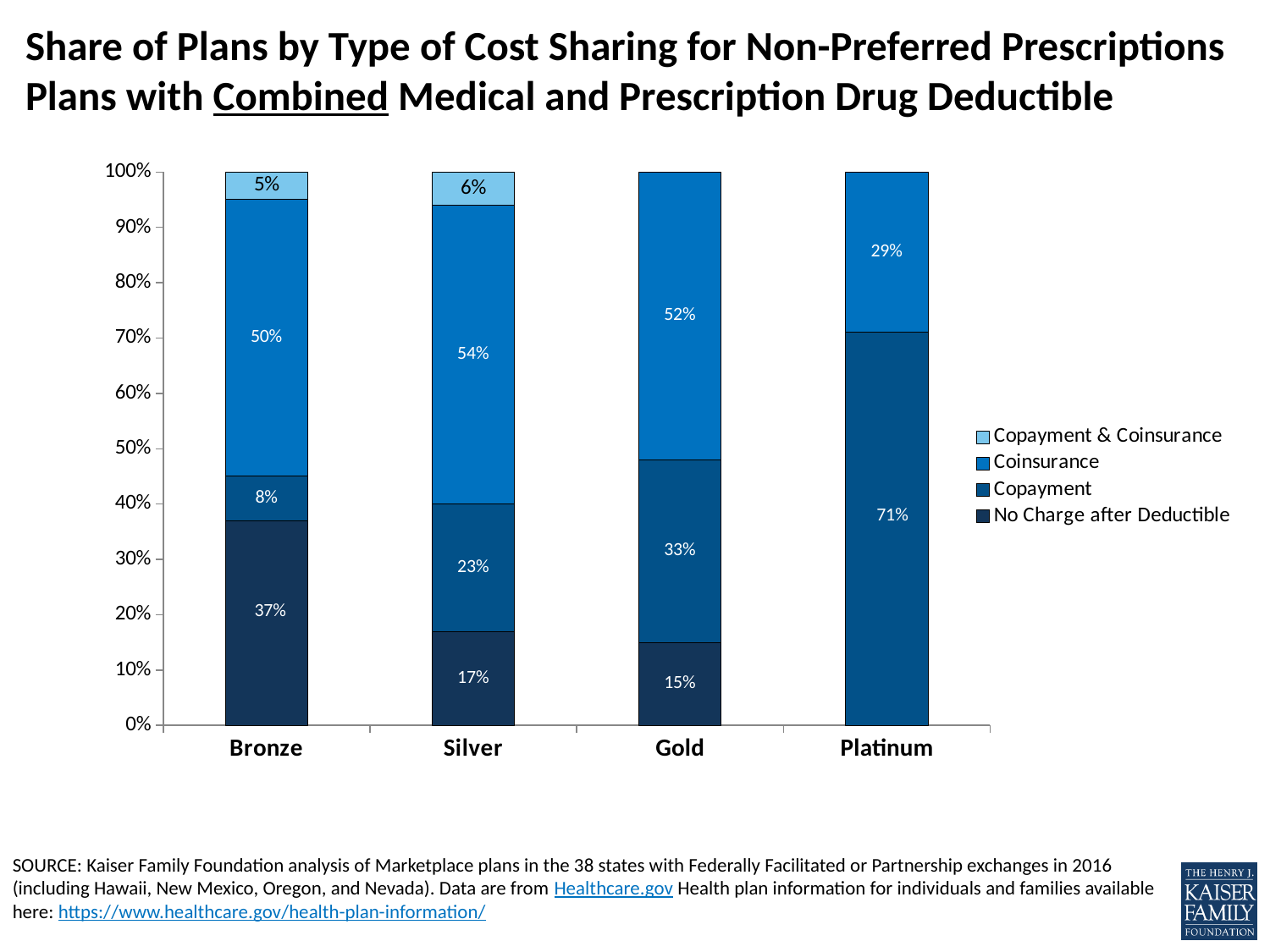
What is the difference in percentage points between the Copayment share for Silver and for Bronze? 15 What is the Coinsurance share for Silver plans? 54% How many plan categories are shown on the x axis? 4 Which plan type has the lowest No Charge after Deductible share? Platinum Which has a larger Copayment & Coinsurance share, Bronze or Silver? Silver What is the Copayment share for Gold plans? 33% What is the No Charge after Deductible share for Bronze plans? 37% What kind of chart is shown on the slide? Stacked bar chart What is the Coinsurance share for Platinum plans? 29% Which plan type has the highest Coinsurance share? Silver Which series is listed first in the legend? Copayment & Coinsurance How many series does the legend list? 4